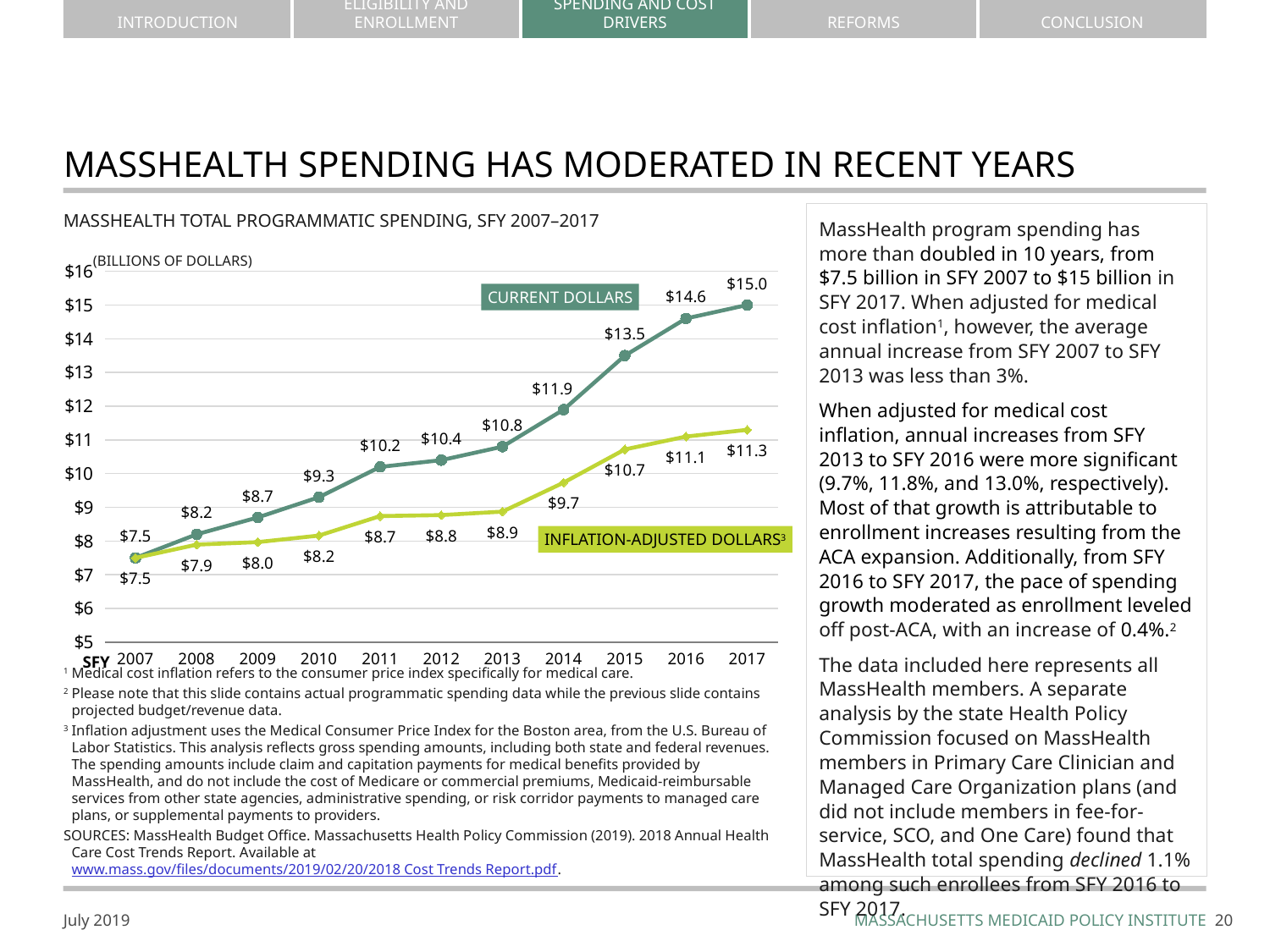
Which is larger: inflation-adjusted spending in SFY 2015 or current-dollar spending in SFY 2012? Inflation-adjusted spending in SFY 2015 What was the inflation-adjusted spending value for SFY 2014? $9.7 What type of chart is shown on the slide? Line chart Which year has the lowest inflation-adjusted spending value? 2007 By how much did current-dollar spending increase from SFY 2007 to SFY 2017? $7.5 Which year has the highest current-dollar spending value? 2017 What was MassHealth total programmatic spending in current dollars in SFY 2017? $15.0 What is the difference between current-dollar spending and inflation-adjusted spending in SFY 2017? $3.7 What was spending in current dollars in SFY 2011? $10.2 How many years are plotted on the x axis of the chart? 11 Does current-dollar spending rise or fall from SFY 2007 to SFY 2017? Rise How many data series does the chart show? 2